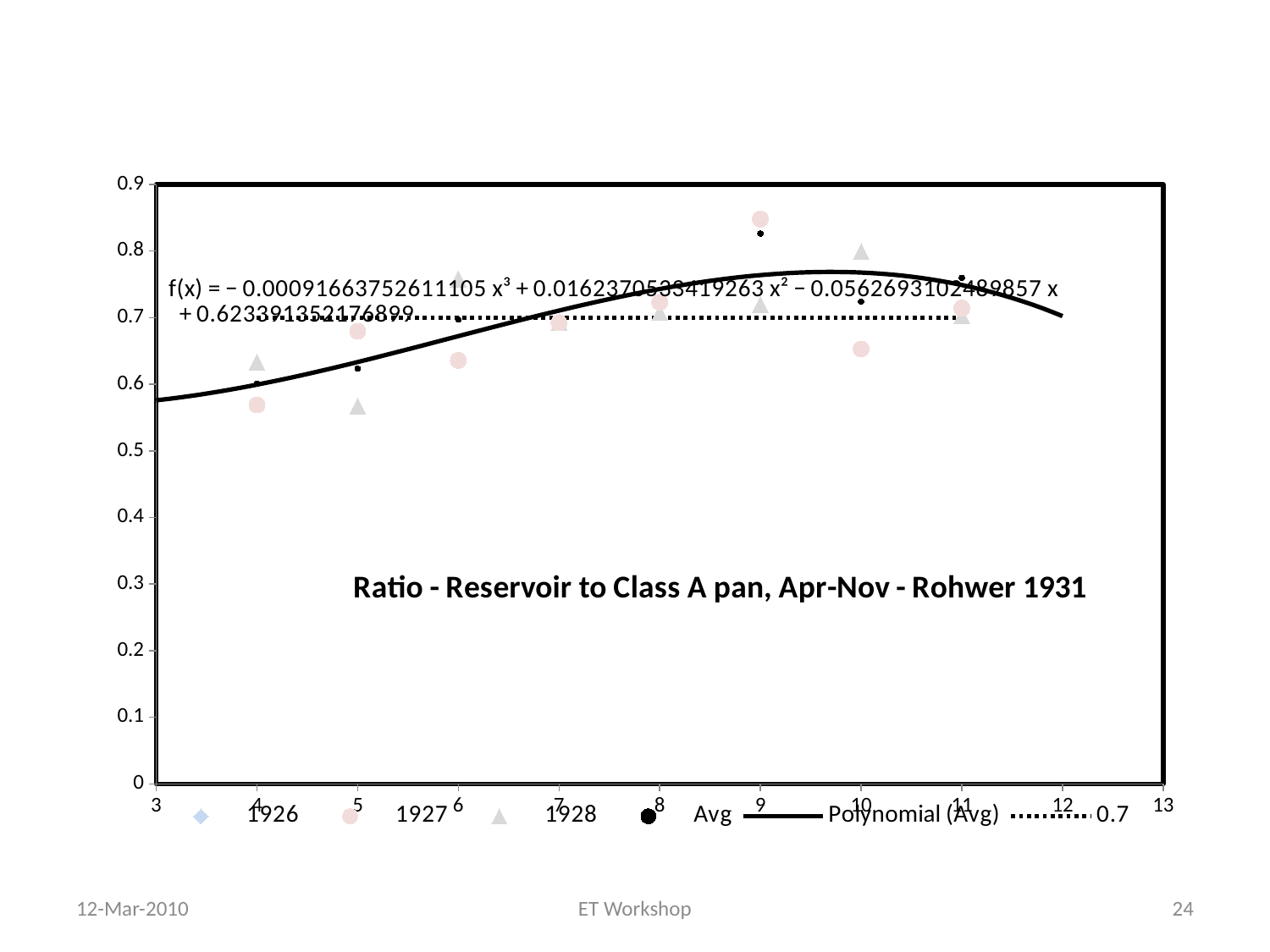
Is the 1928 value at x = 5 greater or less than 0.6? less At x = 9, which series has the larger value, 1927 or 1928? 1927 What is the title of the chart? Ratio - Reservoir to Class A pan, Apr-Nov - Rohwer 1931 How many series does the legend list? 6 At which x value does the 1927 series have its lowest point? 4 Is the 1927 value at x = 9 greater or less than 0.8? greater Does the Polynomial (Avg) trendline rise or fall between x = 4 and x = 9? rise What kind of chart is shown on the slide? scatter chart What value does the dotted horizontal reference line in the legend represent? 0.7 Is the 1927 value at x = 4 greater or less than 0.6? less At which x value does the 1927 series reach its highest point? 9